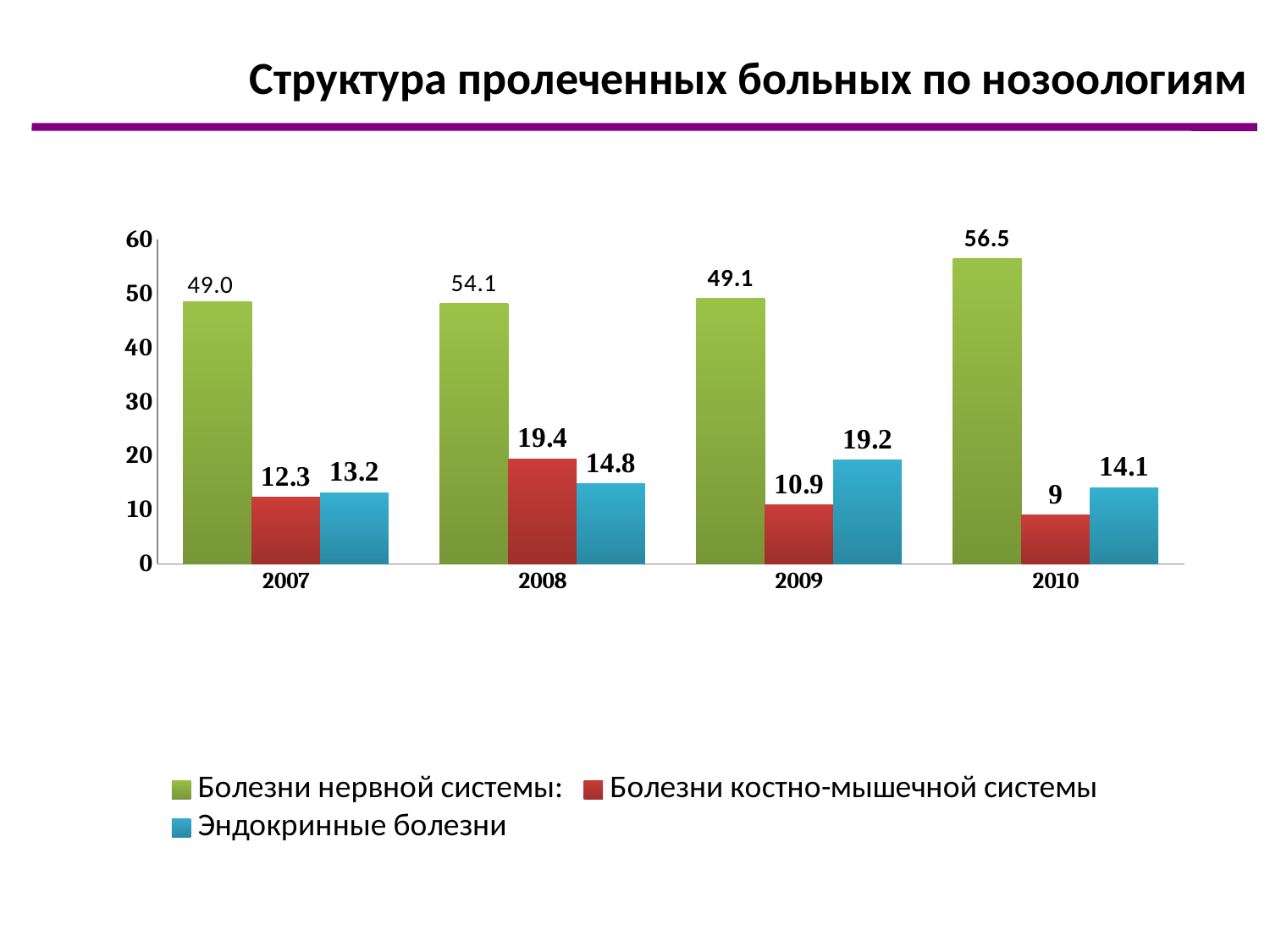
What type of chart is shown on the slide? bar chart What is the value for Болезни костно-мышечной системы in 2008? 19.4 What is the difference between the values for Эндокринные болезни in 2009 and 2007? 6.0 How many years are shown on the x axis? 4 What is the value for Болезни нервной системы in 2010? 56.5 In which year is the value for Болезни костно-мышечной системы the lowest? 2010 Which is larger in 2008: Болезни костно-мышечной системы or Эндокринные болезни? Болезни костно-мышечной системы In which year is the value for Болезни нервной системы the highest? 2010 What is the title of the chart? Структура пролеченных больных по нозоологиям What is the value for Эндокринные болезни in 2009? 19.2 What is the value for Болезни костно-мышечной системы in 2010? 9 How many series does the legend list? 3